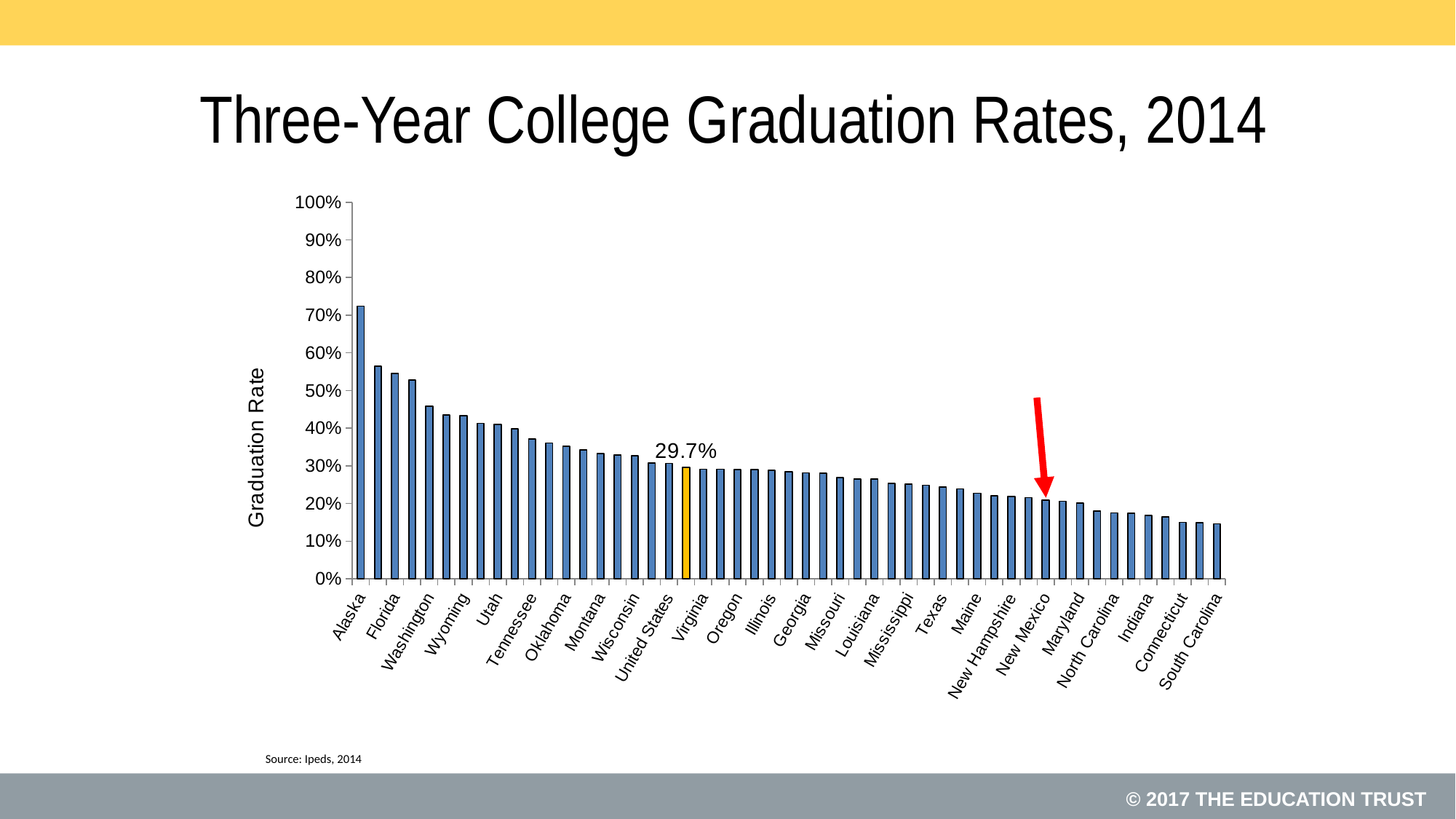
What type of chart is shown on the slide? bar chart Is the graduation rate for Maryland greater or less than 30%? less Which state has the lowest three-year college graduation rate? South Carolina Is the graduation rate for Florida greater or less than 50%? greater Is the graduation rate for South Carolina greater or less than 20%? less What value is printed as a data label on the gold-coloured bar? 29.7% Do the graduation rates rise or fall moving from left to right along the x axis? fall Which state does the red arrow point to? New Mexico Which state has the highest three-year college graduation rate? Alaska Which has a higher graduation rate, Utah or Maryland? Utah Which has a higher graduation rate, Alaska or Florida? Alaska